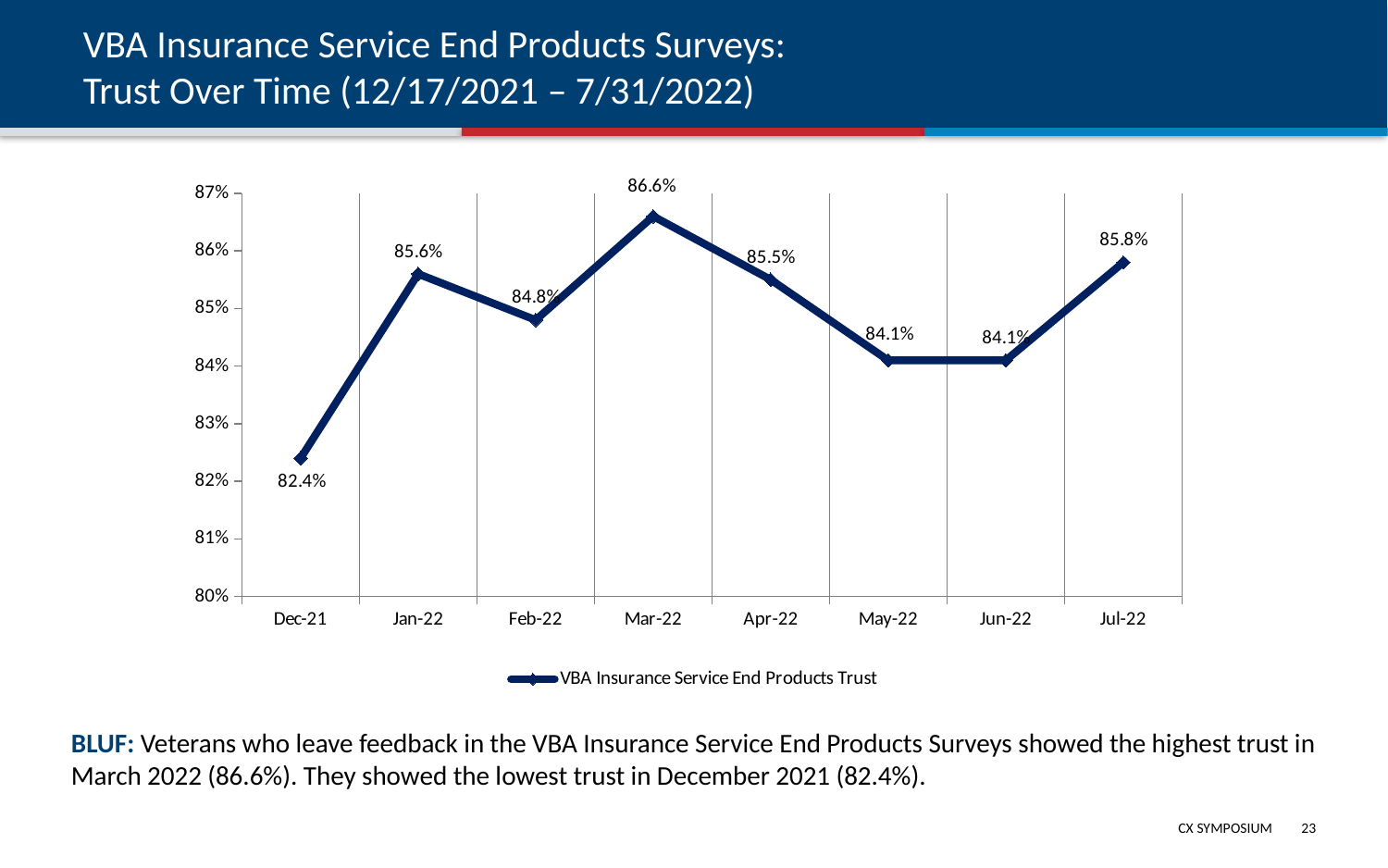
Is the value for Apr-22 greater or less than 85%? greater What is the trust value for Dec-21? 82.4% Which month has the lowest trust value? Dec-21 What is the trust value for Jul-22? 85.8% What kind of chart is shown on the slide? Line chart Which is larger, the trust value for Jan-22 or Feb-22? Jan-22 What is the trust value for Mar-22? 86.6% Which month has the highest trust value? Mar-22 How many months are plotted on the chart? 8 Does the trust value rise or fall from Apr-22 to May-22? Fall What is the difference between the trust values for Mar-22 and Dec-21? 4.2% How many series does the legend list? 1